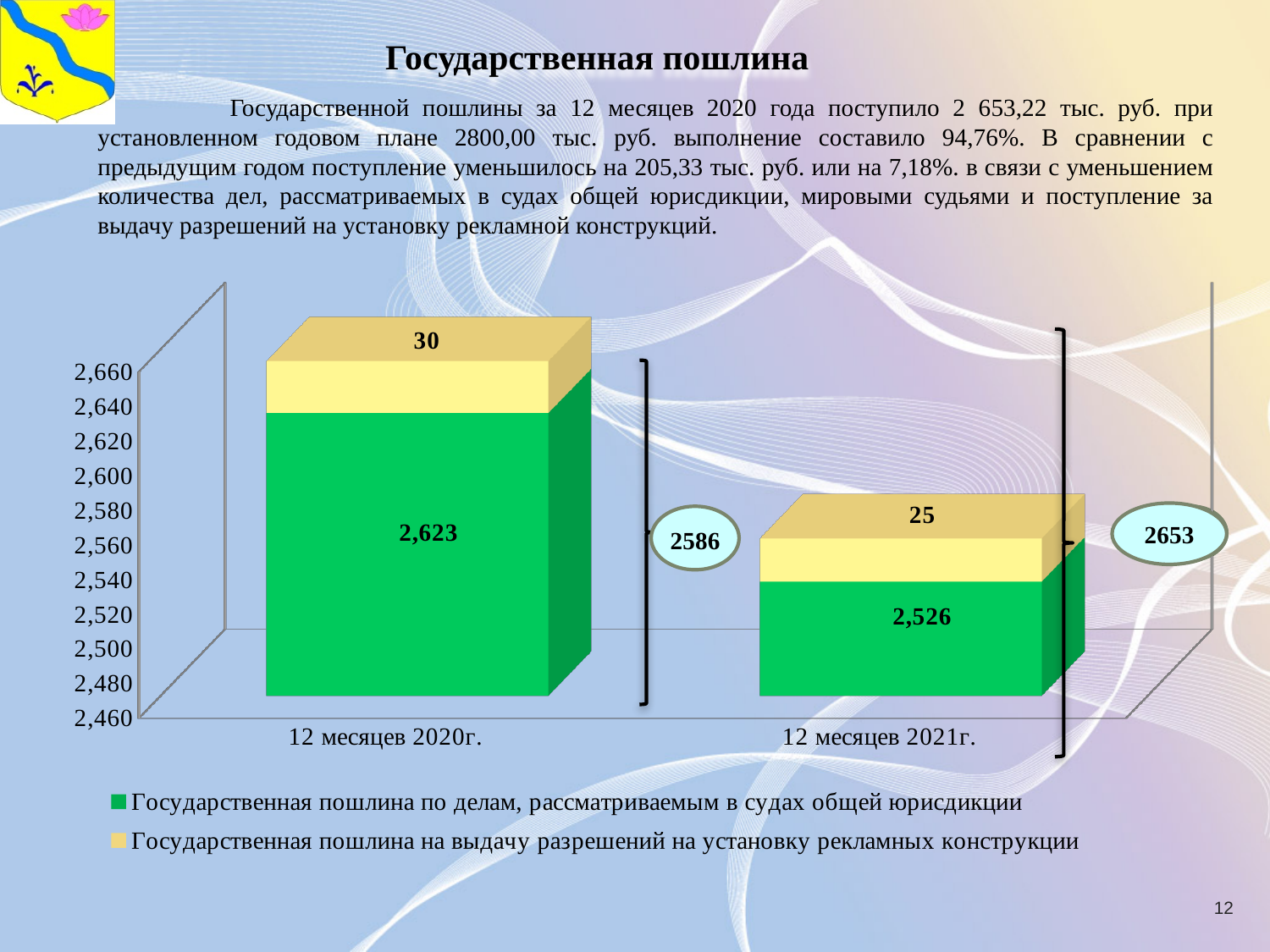
By how much did 'Государственная пошлина по делам, рассматриваемым в судах общей юрисдикции' decrease from '12 месяцев 2020г.' to '12 месяцев 2021г.'? 97 What is the value of 'Государственная пошлина по делам, рассматриваемым в судах общей юрисдикции' for '12 месяцев 2021г.'? 2,526 In which period is 'Государственная пошлина на выдачу разрешений на установку рекламных конструкции' lowest? 12 месяцев 2021г. What is the value of 'Государственная пошлина на выдачу разрешений на установку рекламных конструкции' for '12 месяцев 2021г.'? 25 How many categories are shown on the x axis of the chart? 2 Does the value of 'Государственная пошлина по делам, рассматриваемым в судах общей юрисдикции' rise or fall from 2020 to 2021? Fall How many series does the chart legend list? 2 What is the value of 'Государственная пошлина по делам, рассматриваемым в судах общей юрисдикции' for '12 месяцев 2020г.'? 2,623 What kind of chart is shown on the slide? Stacked bar chart Which period has the larger value for 'Государственная пошлина по делам, рассматриваемым в судах общей юрисдикции'? 12 месяцев 2020г. What is the difference between the 2020 and 2021 values of 'Государственная пошлина на выдачу разрешений на установку рекламных конструкции'? 5 What is the value of 'Государственная пошлина на выдачу разрешений на установку рекламных конструкции' for '12 месяцев 2020г.'? 30